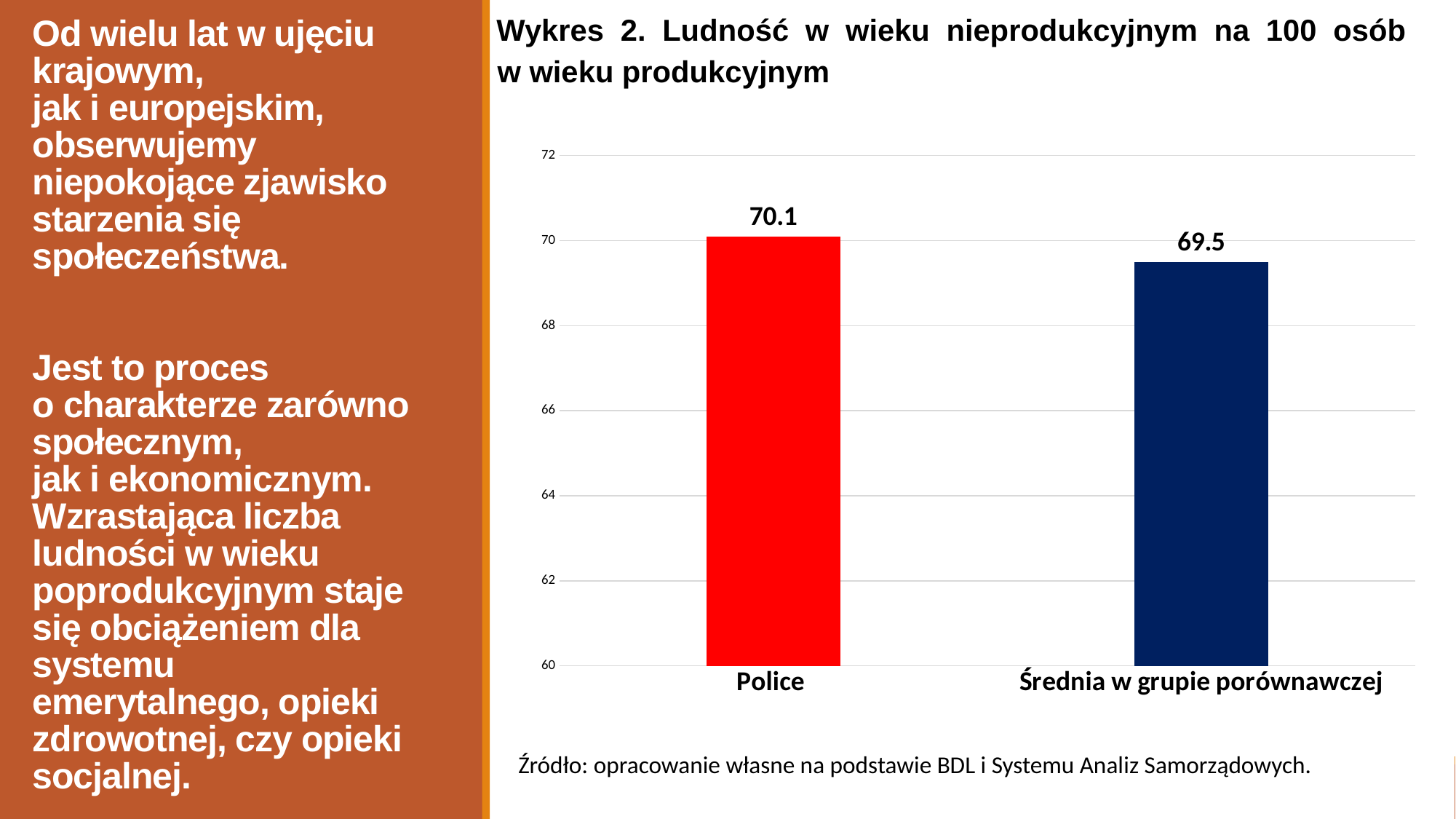
Is the value for Police greater or less than 70? greater What is the value for Średnia w grupie porównawczej? 69.5 What is the value for Police? 70.1 How many categories are shown on the chart? 2 Which is larger, the value for Police or the value for Średnia w grupie porównawczej? Police What colour is the bar for Police? red What is the title of the chart? Wykres 2. Ludność w wieku nieprodukcyjnym na 100 osób w wieku produkcyjnym Which category has the lowest value? Średnia w grupie porównawczej Is the value for Średnia w grupie porównawczej greater or less than 70? less What is the difference between the value for Police and the value for Średnia w grupie porównawczej? 0.6 What kind of chart is shown on the slide? bar chart Which category has the highest value? Police